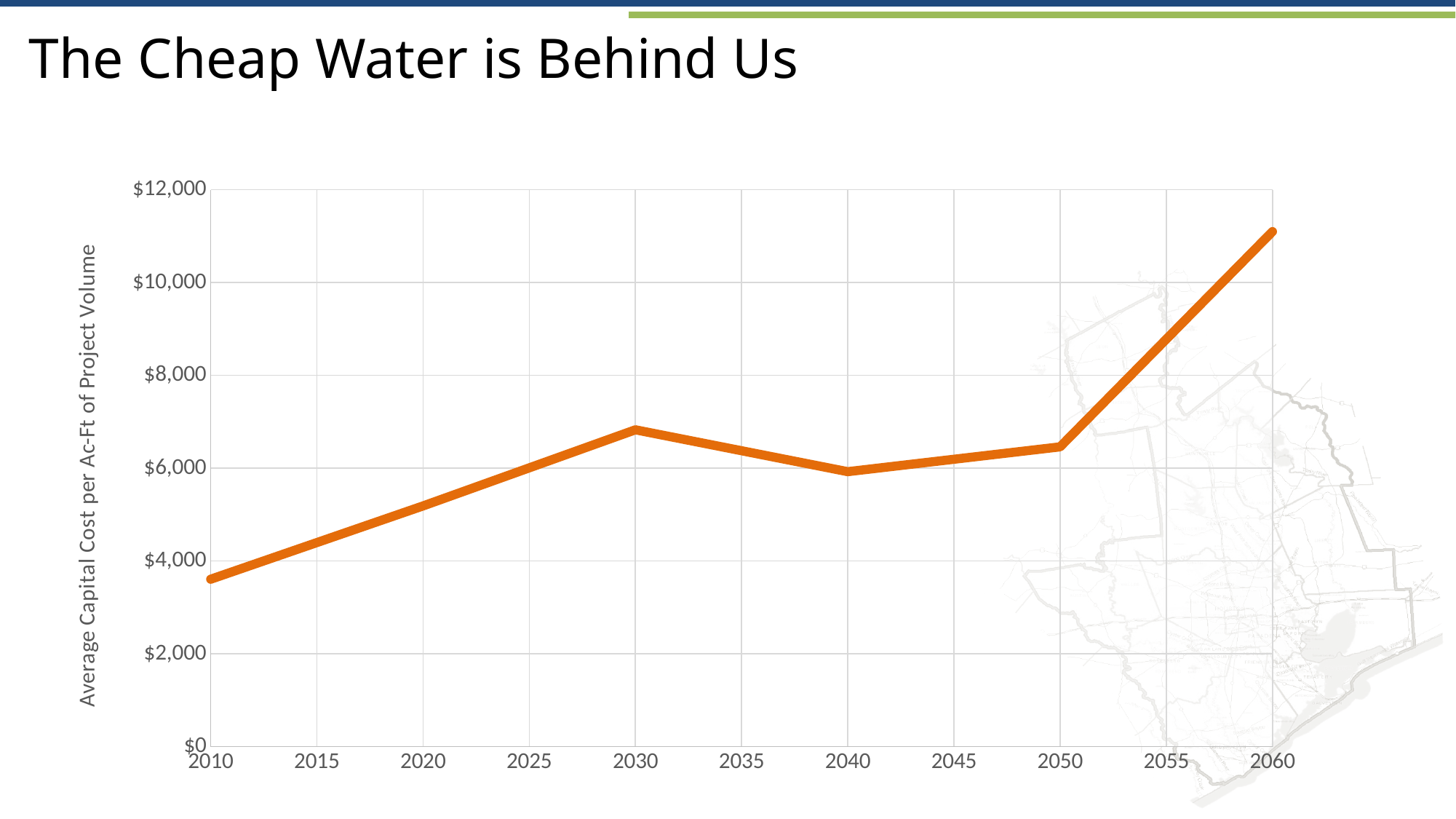
What is the label on the vertical axis of the chart? Average Capital Cost per Ac-Ft of Project Volume Does the line rise or fall between 2050 and 2060? rise Which year has the lowest average capital cost per Ac-Ft of project volume? 2010 Which year has the larger value, 2020 or 2050? 2050 Is the value for 2040 greater or less than $8,000? less Is the value for 2030 greater or less than $6,000? greater Is the value for 2010 greater or less than $4,000? less How many data points are plotted on the line? 6 Which year has the larger value, 2030 or 2040? 2030 What kind of chart is shown on the slide? line chart Which year has the highest average capital cost per Ac-Ft of project volume? 2060